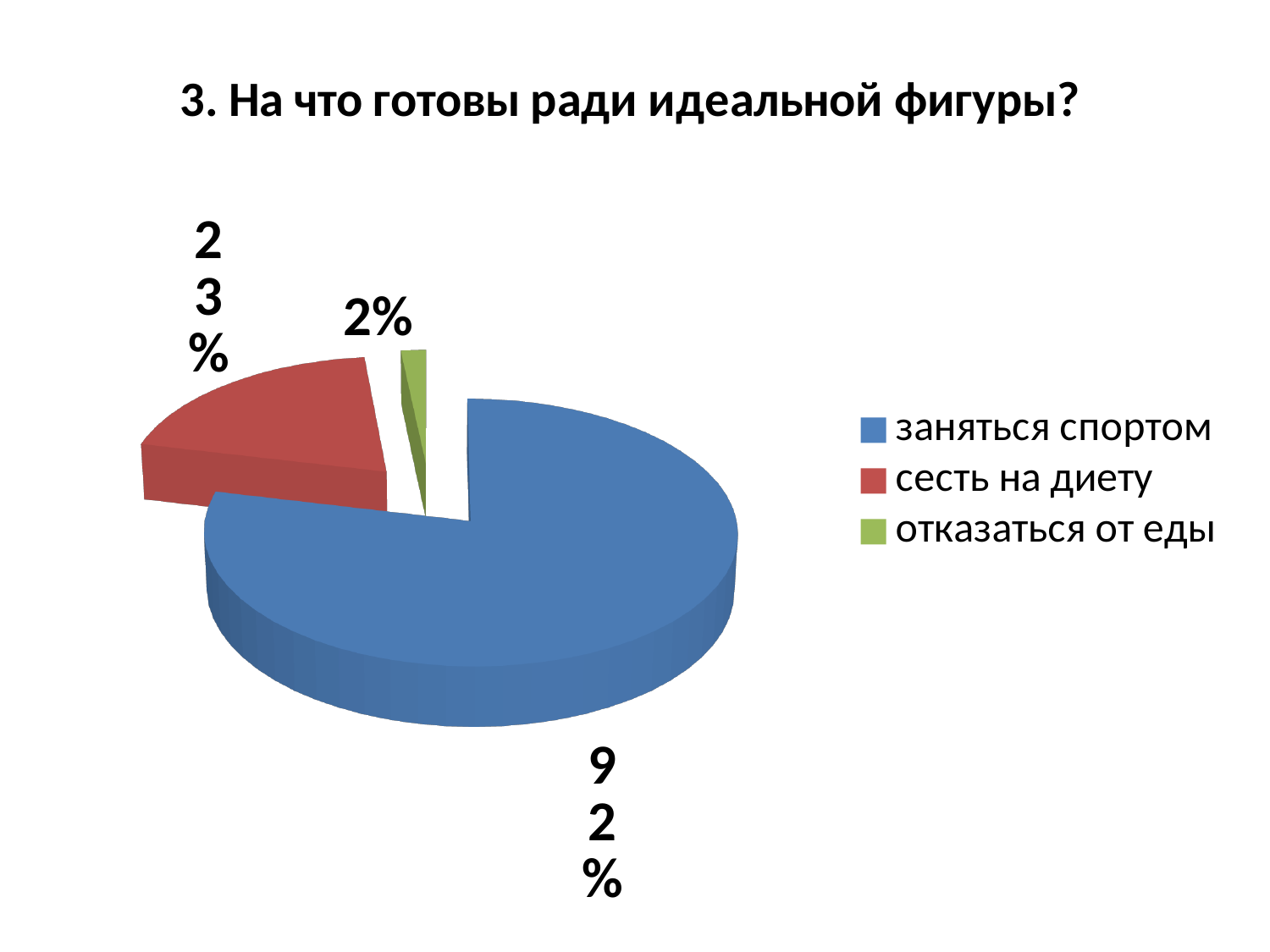
What colour is the slice for "сесть на диету"? red What percentage is shown for the slice "отказаться от еды"? 2% Which is larger: the slice for "сесть на диету" or the slice for "отказаться от еды"? сесть на диету Which category has the largest slice of the pie? заняться спортом What percentage is shown for the slice "сесть на диету"? 23% What kind of chart is shown on the slide? pie chart What is the difference in percentage points between the "сесть на диету" slice and the "отказаться от еды" slice? 21 Which category has the smallest slice of the pie? отказаться от еды What is the difference in percentage points between the "заняться спортом" slice and the "сесть на диету" slice? 69 What percentage is shown for the slice "заняться спортом"? 92% How many slices does the pie chart have? 3 How many entries does the legend list? 3